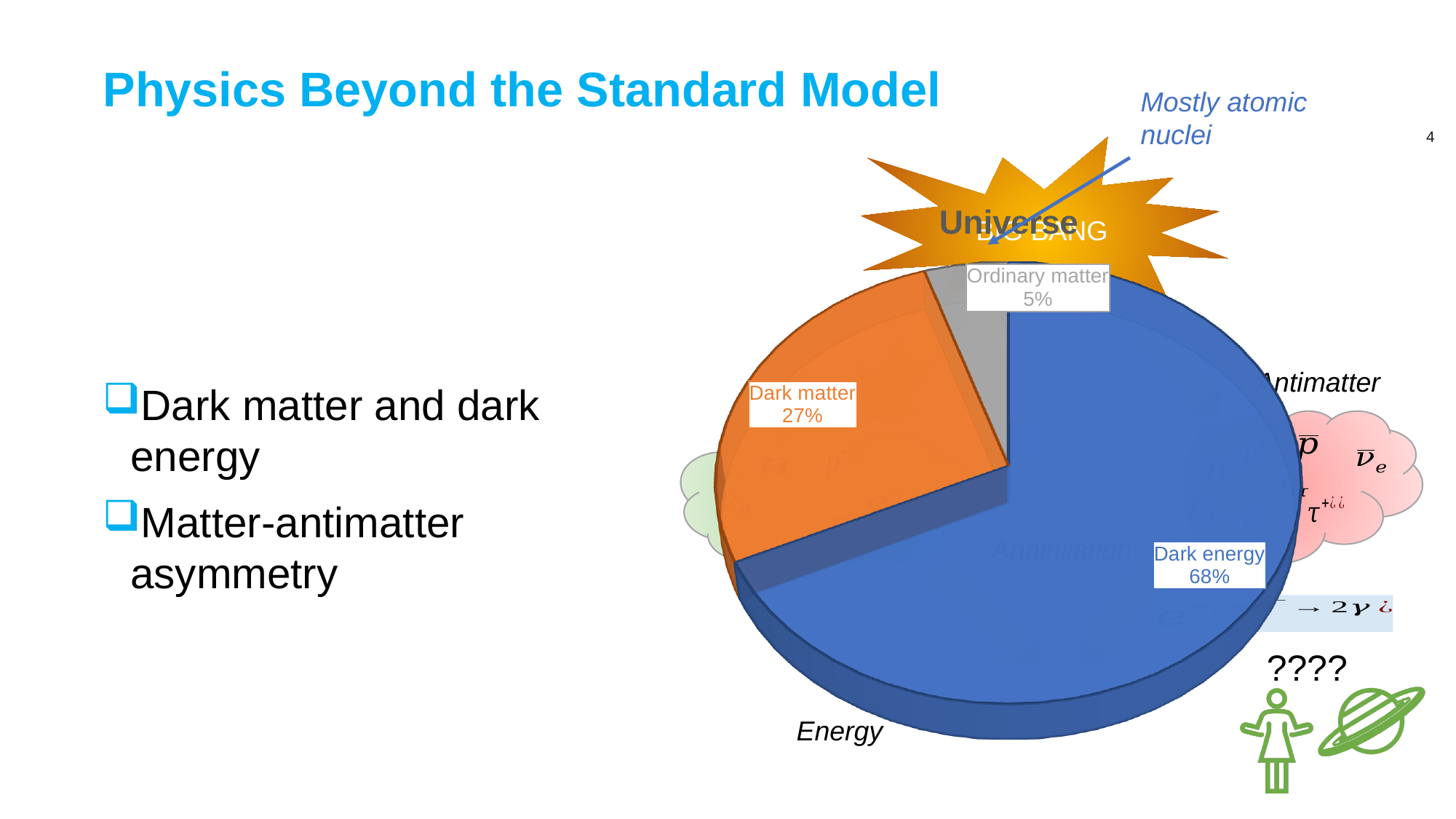
What is the title of the pie chart? Universe Which is larger, the Dark matter slice or the Ordinary matter slice? Dark matter Which slice of the pie chart is the largest? Dark energy What is the difference between the Dark energy and Dark matter shares? 41% What share of the pie does Dark energy have? 68% Which slice of the pie chart is the smallest? Ordinary matter What share of the pie does Ordinary matter have? 5% What kind of chart is shown on the slide? pie chart What colour is the Dark energy slice of the pie chart? blue What share of the pie does Dark matter have? 27% What is the difference between the Dark matter and Ordinary matter shares? 22% How many slices does the pie chart have? 3